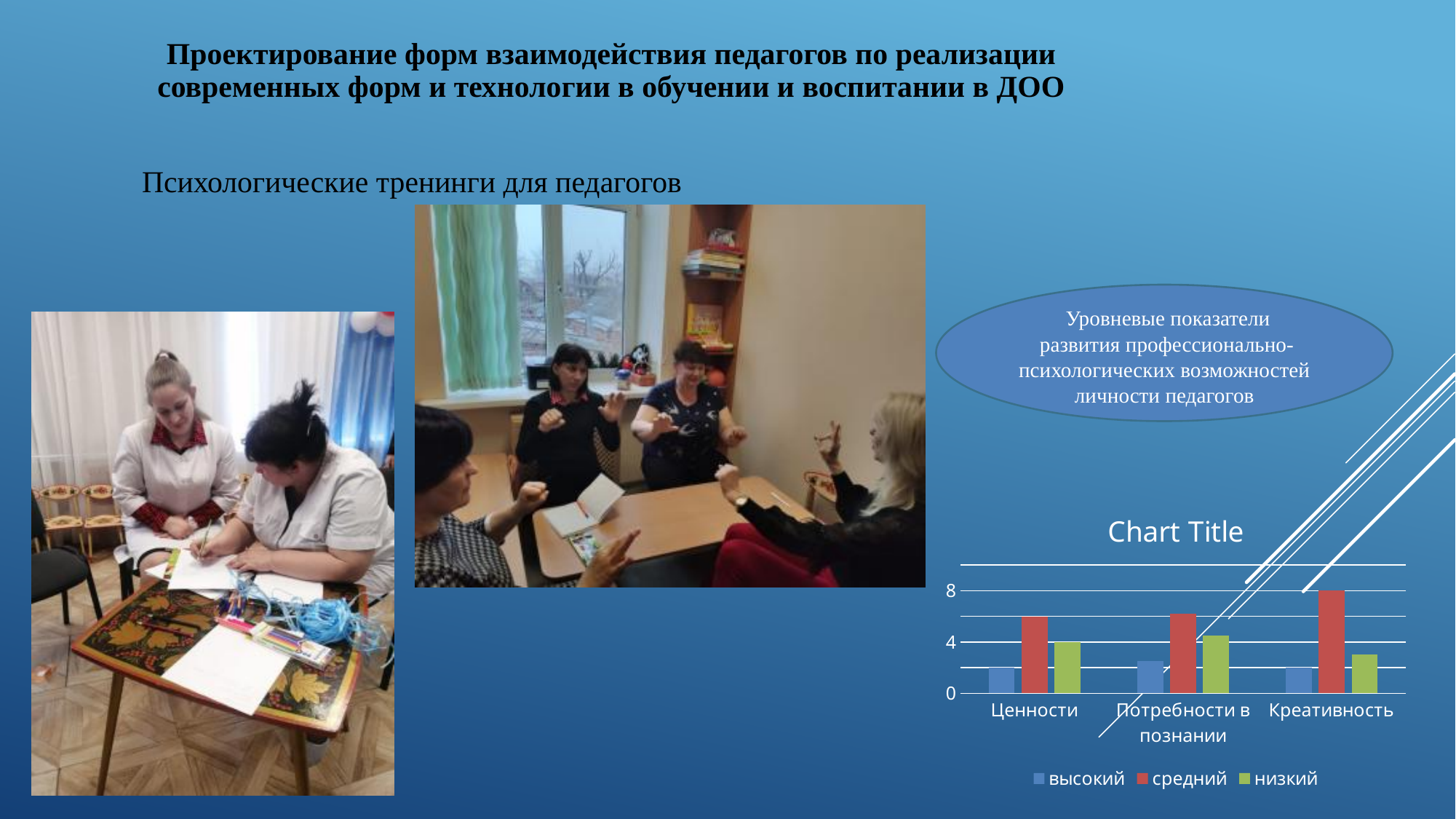
Within the Креативность category, which series has the lowest value? высокий How many categories are shown on the x axis of the chart? 3 Within the Ценности category, which series has the highest value? средний How many series does the chart legend list? 3 What is the title shown above the chart? Chart Title Which category has the highest value for the средний series? Креативность What kind of chart is shown on the slide? bar chart In the Потребности в познании category, which is larger: the средний value or the высокий value? средний Is the value for средний in Креативность greater or less than 4? greater Which series is shown in red in the chart? средний Is the value for высокий in Ценности greater or less than 4? less Is the value for низкий in Креативность greater or less than 4? less